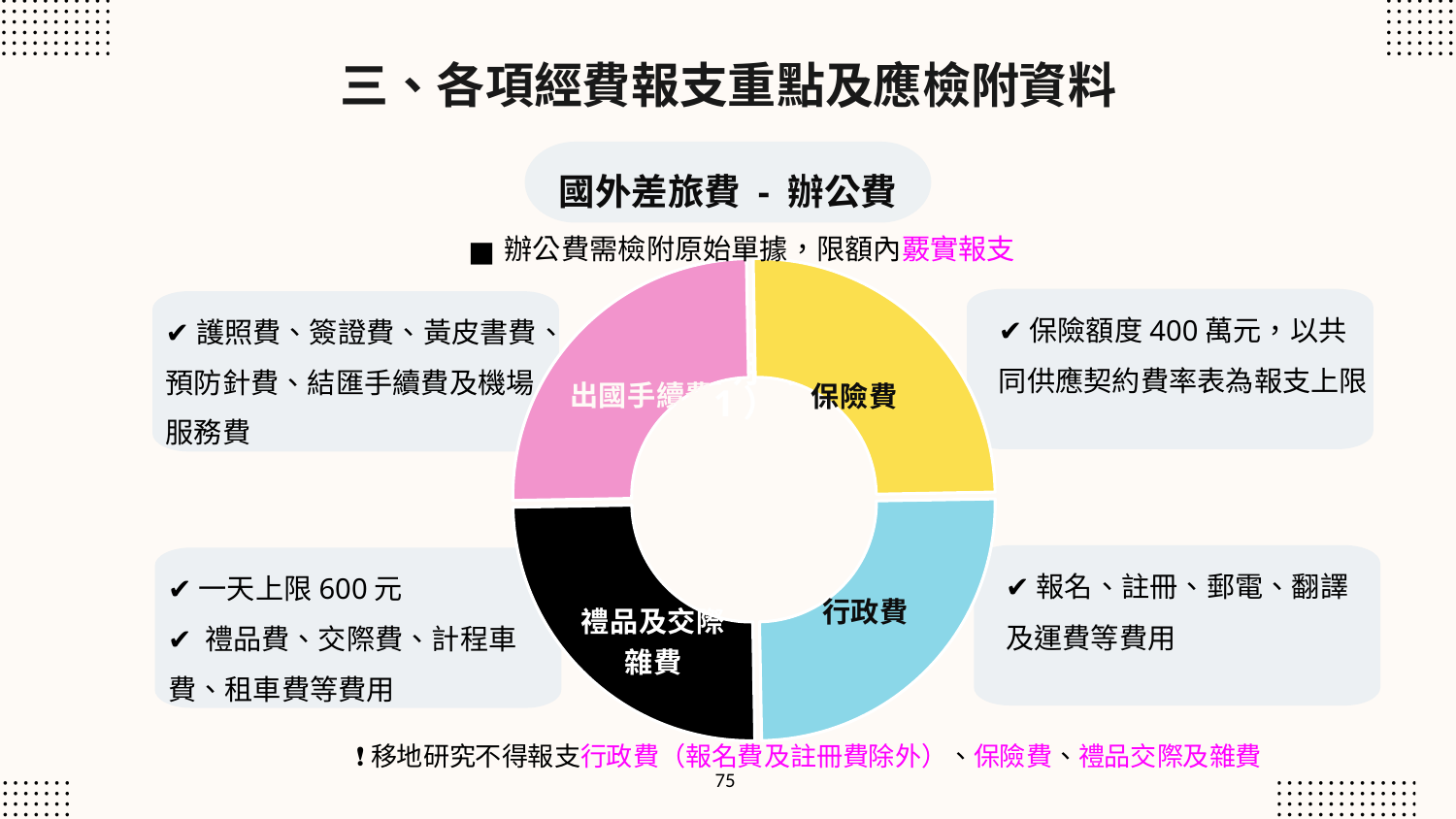
Which segment of the doughnut chart is coloured yellow? 保險費 Which segment of the doughnut chart is located in the upper-right quadrant? 保險費 Are the four segments of the doughnut chart shown as equal in size? Yes Does the doughnut chart display any numeric data labels on its segments? No How many segments does the doughnut chart have? 4 Which segment of the doughnut chart is located in the lower-left quadrant? 禮品及交際雜費 What is the label of the light blue segment in the doughnut chart? 行政費 What kind of chart is shown on the slide? Doughnut chart Which segment of the doughnut chart is coloured black? 禮品及交際雜費 What is the label of the pink segment in the doughnut chart? 出國手續費